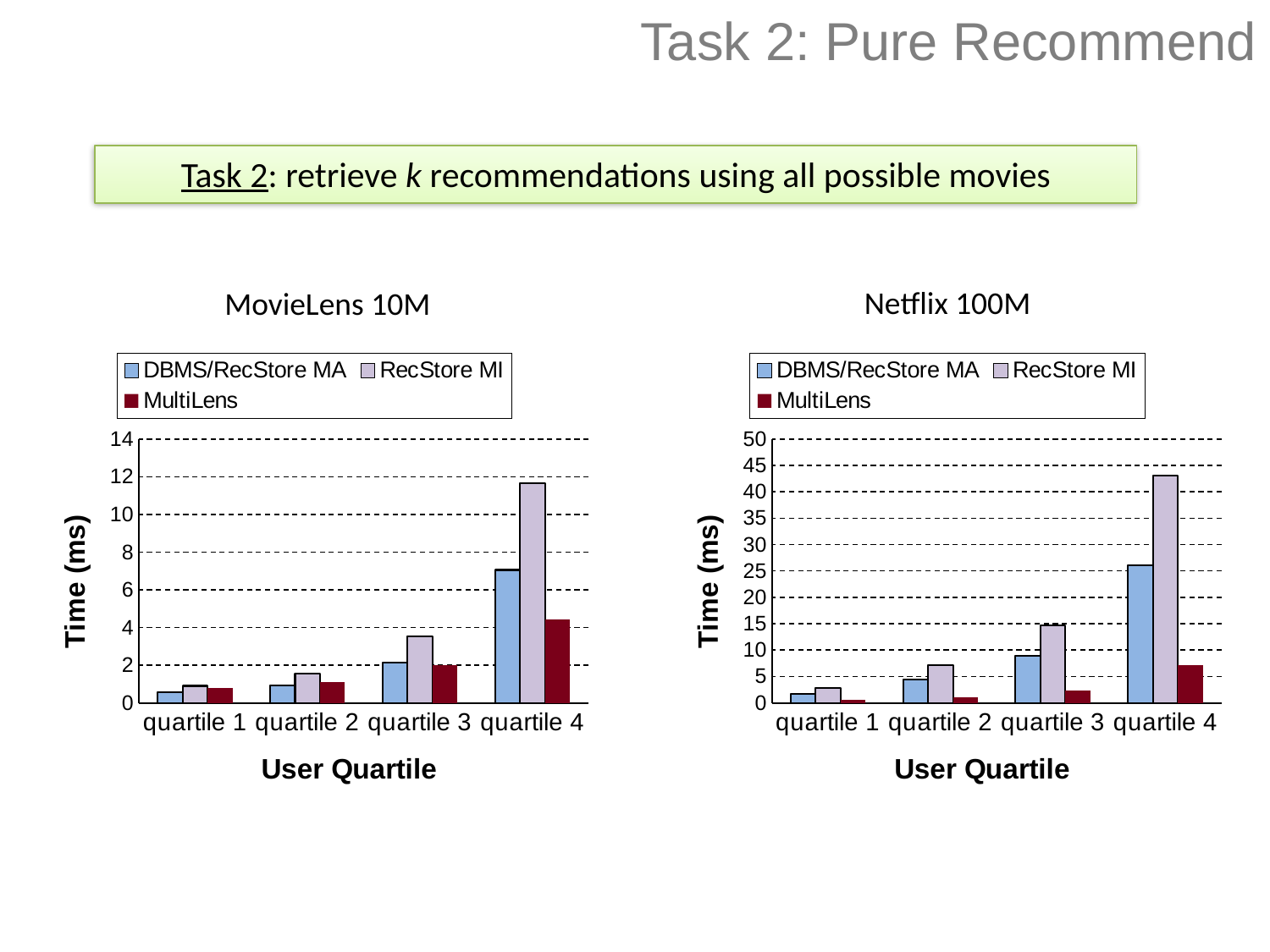
In the Netflix 100M chart, do the RecStore MI values rise or fall from quartile 1 to quartile 4? rise How many series does the legend of the MovieLens 10M chart list? 3 In the Netflix 100M chart, which series has the lowest value at quartile 4? MultiLens In the Netflix 100M chart, which is larger at quartile 3: DBMS/RecStore MA or RecStore MI? RecStore MI In the MovieLens 10M chart, is the value for DBMS/RecStore MA at quartile 4 greater or less than 6? greater In the MovieLens 10M chart, is the value for RecStore MI at quartile 4 greater or less than 10? greater In the Netflix 100M chart, is the value for MultiLens at quartile 4 greater or less than 10? less In the MovieLens 10M chart, which is larger at quartile 4: DBMS/RecStore MA or MultiLens? DBMS/RecStore MA In the MovieLens 10M chart, which series has the highest value at quartile 4? RecStore MI What kind of chart is the Netflix 100M chart? bar chart How many user quartile categories are shown on the x axis of the Netflix 100M chart? 4